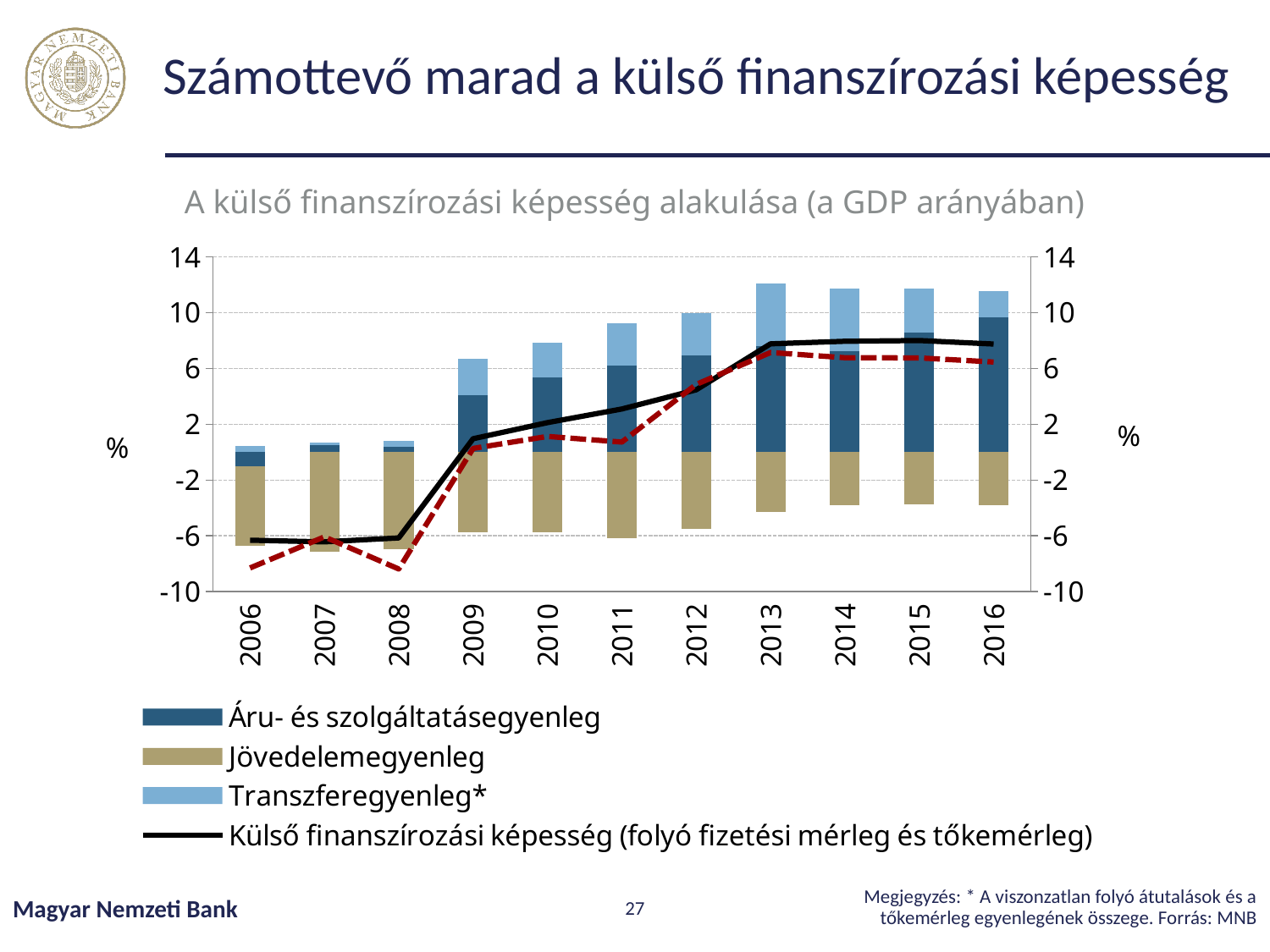
What kind of chart is shown on the slide? Bar chart (stacked bars with lines) Does the Külső finanszírozási képesség line rise or fall between 2008 and 2013? rise What unit is shown on the vertical axes of the chart? % What is the title of the chart? A külső finanszírozási képesség alakulása (a GDP arányában) Is the value of Külső finanszírozási képesség in 2006 greater or less than -2? less Is the value of Külső finanszírozási képesség in 2013 greater or less than 6? greater How many years are shown on the x axis of the chart? 11 How many series does the legend list? 4 Is the value of Jövedelemegyenleg in 2006 greater or less than -2? less Which year has the highest value for Áru- és szolgáltatásegyenleg? 2016 Is the Áru- és szolgáltatásegyenleg value larger in 2006 or in 2016? 2016